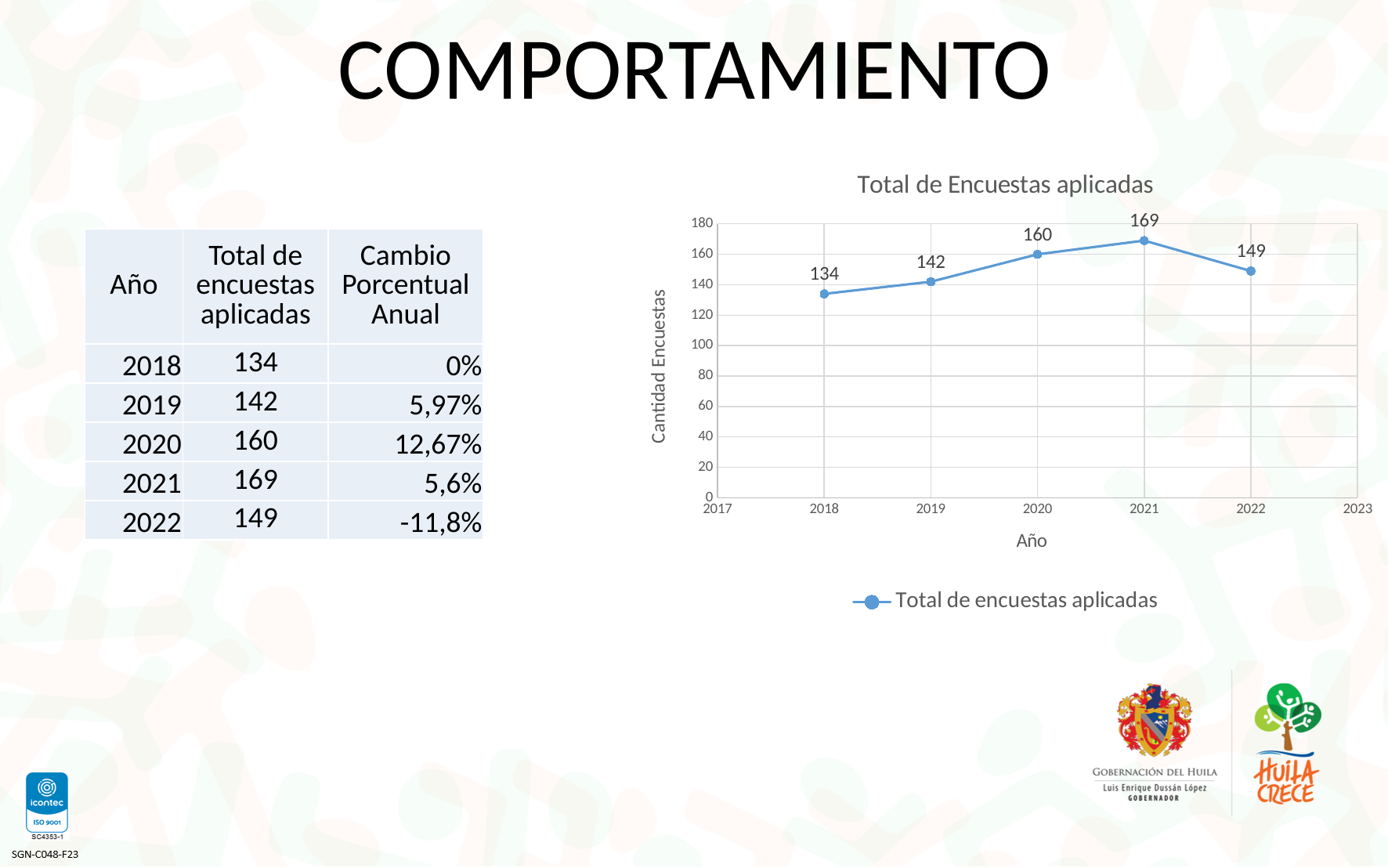
What is the value for 2021 in the chart? 169 Which is larger, the value for 2019 or the value for 2020? 2020 What is the title of the chart? Total de Encuestas aplicadas What is the value for 2022 in the chart? 149 How many data points are plotted in the chart? 5 Which year has the highest value in the chart? 2021 How many series does the legend list? 1 Which year has the lowest value in the chart? 2018 What is the value for 2018 in the chart? 134 What is the difference between the values for 2021 and 2022? 20 What kind of chart is shown on the slide? line chart Is the value for 2020 greater or less than 140? greater